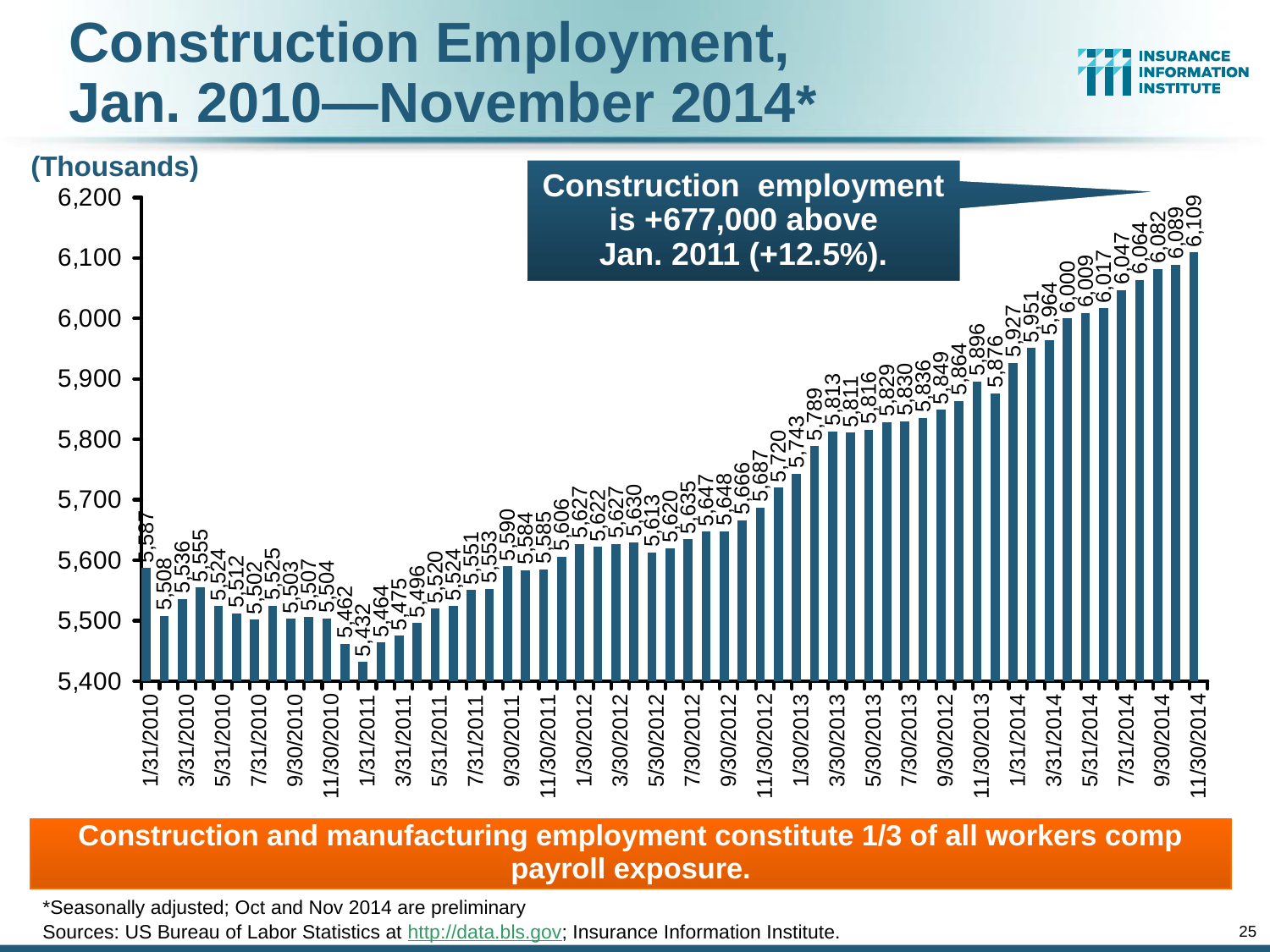
What is the construction employment value for 1/31/2011? 5,432 What is the construction employment value for 1/31/2014? 5,927 Do construction employment values generally rise or fall from 1/31/2011 to 11/30/2014? Rise What kind of chart is shown on the slide? Bar chart What is the construction employment value for 11/30/2014? 6,109 Which month has the lowest construction employment value? 1/31/2011 In what unit are the values on the y axis expressed? Thousands Which is larger, the value for 1/31/2010 or the value for 1/31/2011? 1/31/2010 Which month has the highest construction employment value? 11/30/2014 Is the value for 7/31/2014 greater or less than 6,000? greater What is the difference between the construction employment values for 11/30/2014 and 1/31/2010? 522 What is the construction employment value for 1/31/2010? 5,587